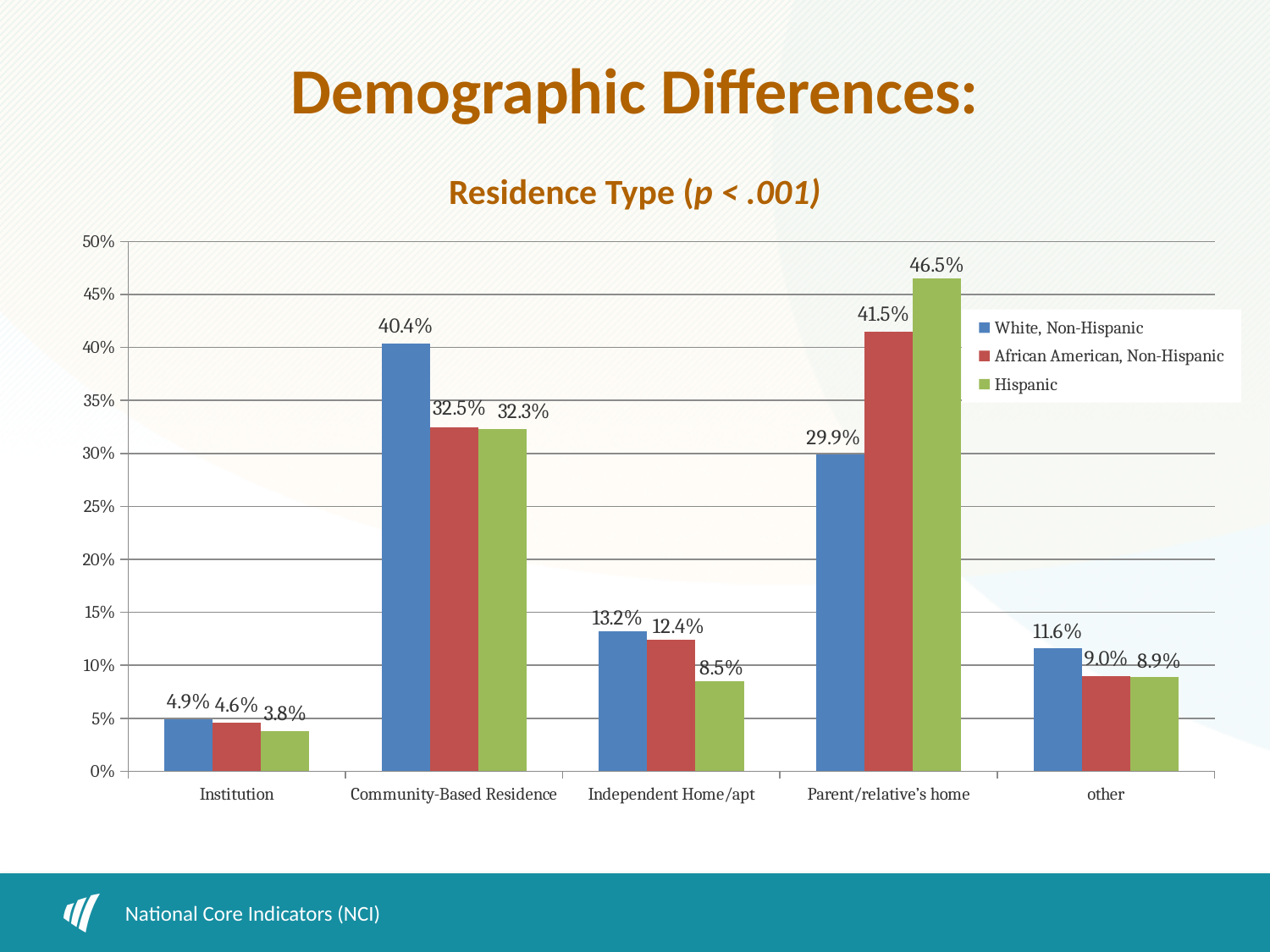
How many residence type categories are shown on the x axis? 5 Which category has the lowest value for the Hispanic series? Institution What is the difference between the Hispanic and White, Non-Hispanic values in the Parent/relative's home category? 16.6% In the Institution category, which is larger: the White, Non-Hispanic value or the Hispanic value? White, Non-Hispanic What colour represents the Hispanic series in the chart? Green What is the value for African American, Non-Hispanic in the Independent Home/apt category? 12.4% What is the value for White, Non-Hispanic in the Community-Based Residence category? 40.4% What kind of chart is shown on the slide? Bar chart Is the value for African American, Non-Hispanic in the Parent/relative's home category greater or less than 40%? greater How many series does the legend list? 3 What is the value for Hispanic in the Parent/relative's home category? 46.5% Which category has the highest value for the White, Non-Hispanic series? Community-Based Residence